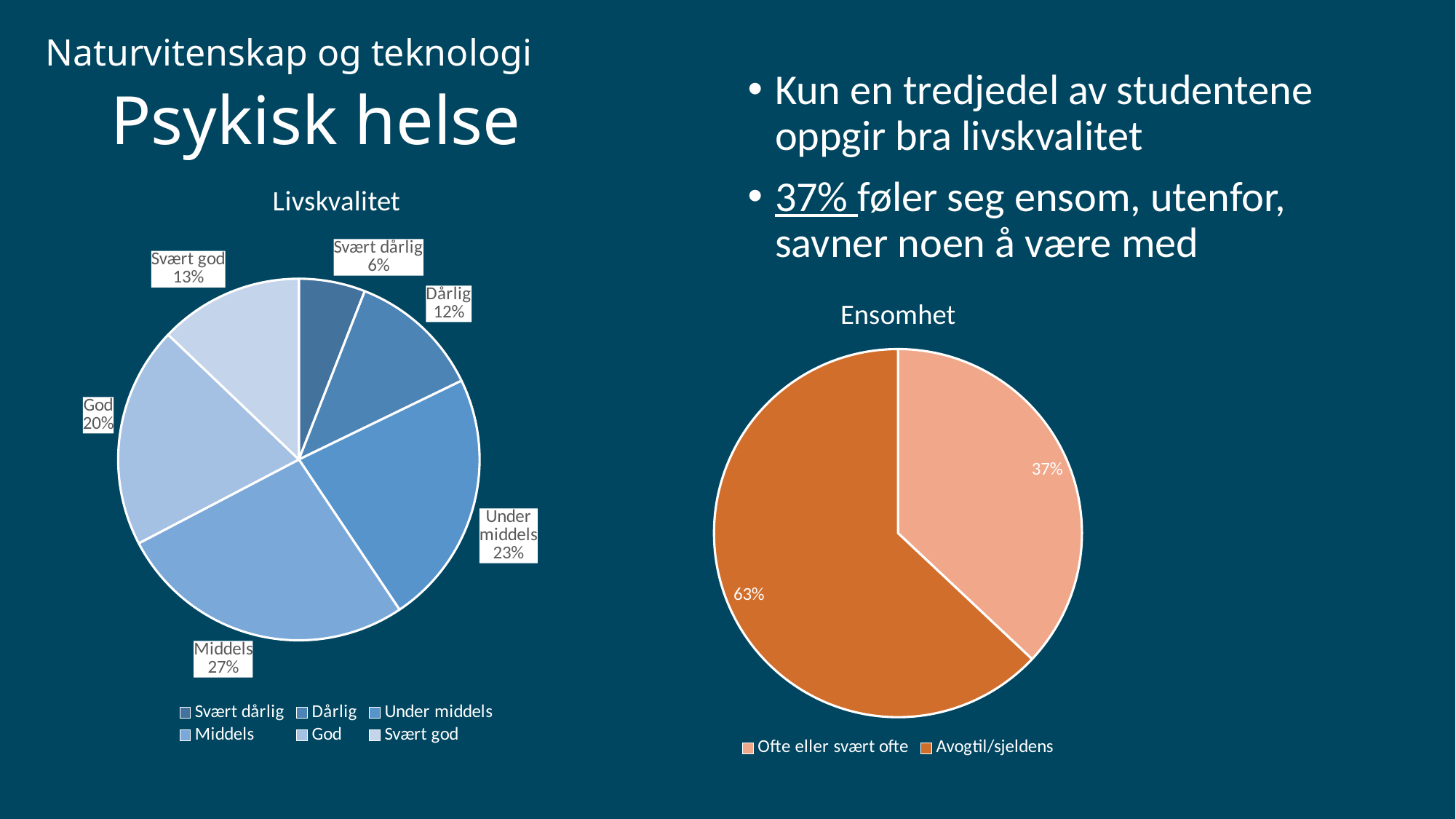
How many entries does the legend of the Ensomhet chart list? 2 In the Livskvalitet chart, what is the difference in percentage points between Under middels and Dårlig? 11 What kind of chart is the Livskvalitet chart? Pie chart In the Livskvalitet chart, what percentage is shown for Svært dårlig? 6% In the Livskvalitet chart, what percentage is shown for God? 20% How many categories does the Livskvalitet chart show? 6 In the Livskvalitet chart, what percentage is shown for Middels? 27% In the Ensomhet chart, what percentage is shown for Avogtil/sjeldens? 63% In the Livskvalitet chart, which category has the largest share? Middels In the Livskvalitet chart, which is larger: God or Svært god? God In the Livskvalitet chart, which category has the smallest share? Svært dårlig In the Ensomhet chart, what percentage is shown for Ofte eller svært ofte? 37%